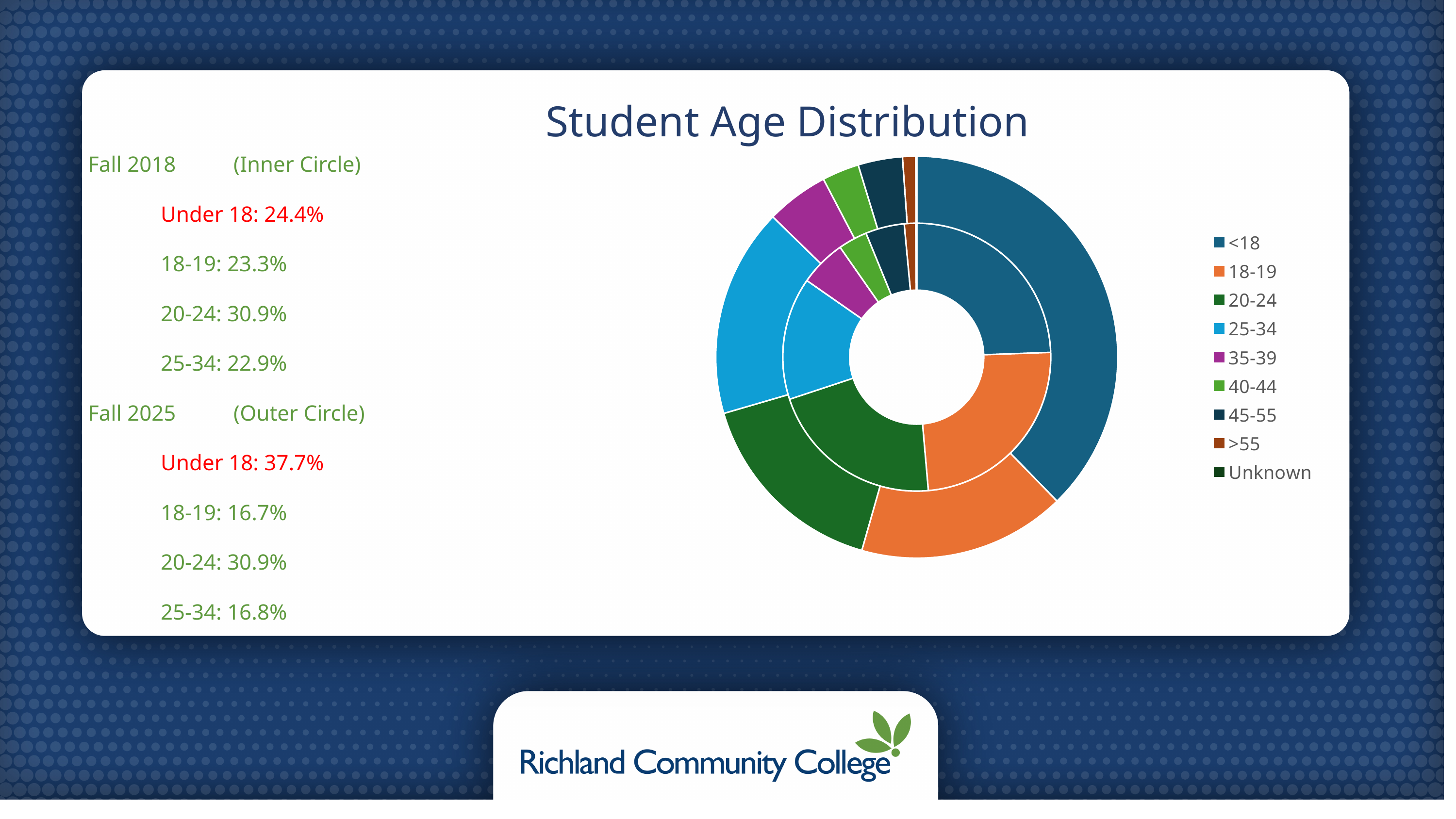
What share of students were aged 25-34 in Fall 2018? 22.9% What kind of chart is shown on the slide? Doughnut chart Which age group has the largest share in the Fall 2025 outer circle? <18 Which ring of the chart represents Fall 2018? Inner circle By how many percentage points did the Under 18 share change from Fall 2018 to Fall 2025? 13.3 percentage points What share of students were aged 18-19 in Fall 2025? 16.7% What share of students were Under 18 in Fall 2018? 24.4% What share of students were Under 18 in Fall 2025? 37.7% What is the title of the chart? Student Age Distribution How many age categories does the legend list? 9